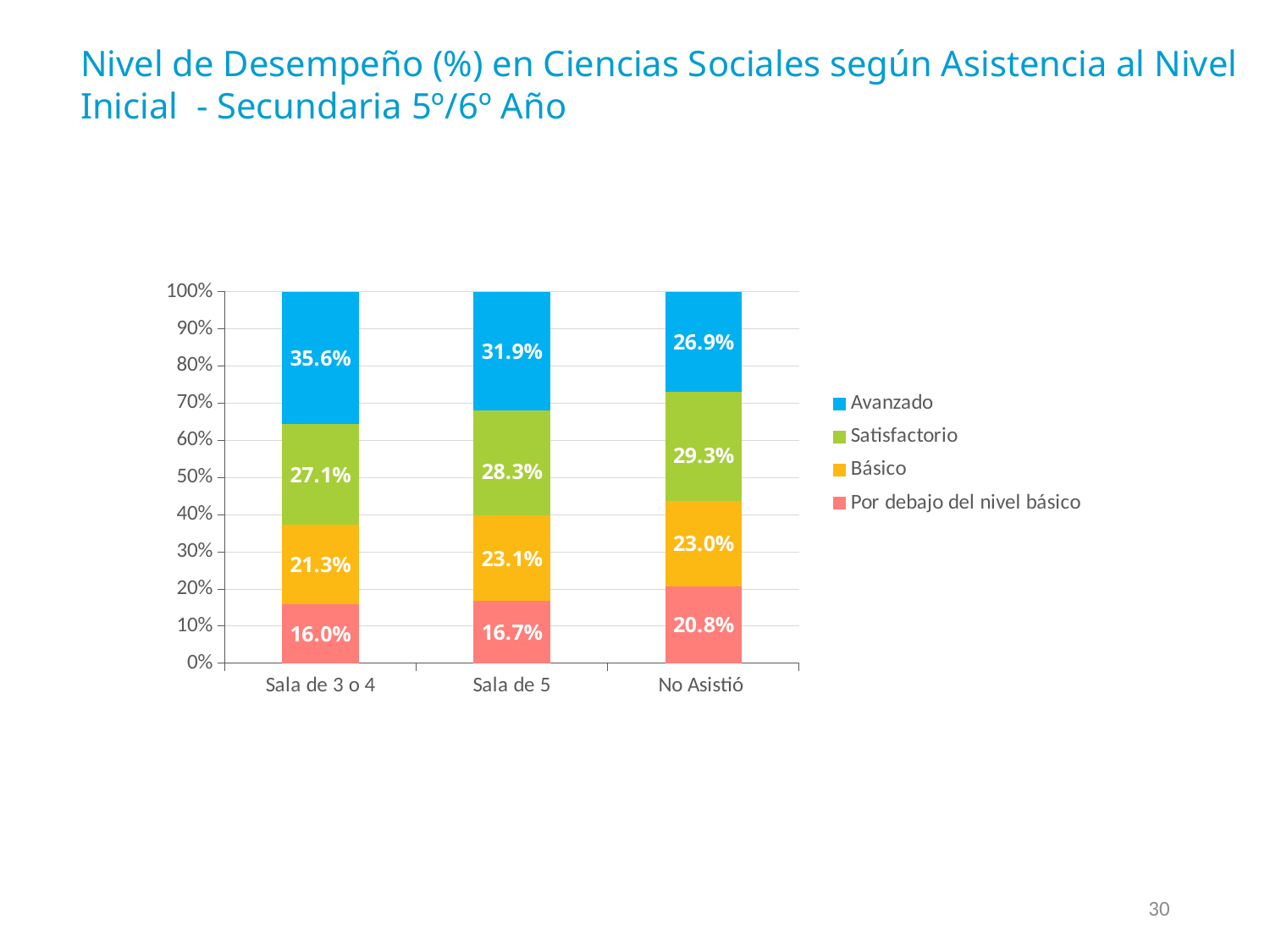
What is the Por debajo del nivel básico value for No Asistió? 20.8% What is the Básico value for Sala de 5? 23.1% How many categories are shown on the x axis? 3 What is the difference between the Avanzado values for Sala de 3 o 4 and No Asistió? 8.7% What kind of chart is shown on the slide? Stacked bar chart What is the Satisfactorio value for No Asistió? 29.3% Which category has the lowest Por debajo del nivel básico value? Sala de 3 o 4 How many series does the legend list? 4 Which is larger: the Básico value for Sala de 5 or for No Asistió? Sala de 5 What is the Avanzado value for Sala de 3 o 4? 35.6% Which category has the highest Avanzado value? Sala de 3 o 4 Do the Avanzado values rise or fall from Sala de 3 o 4 to No Asistió? Fall